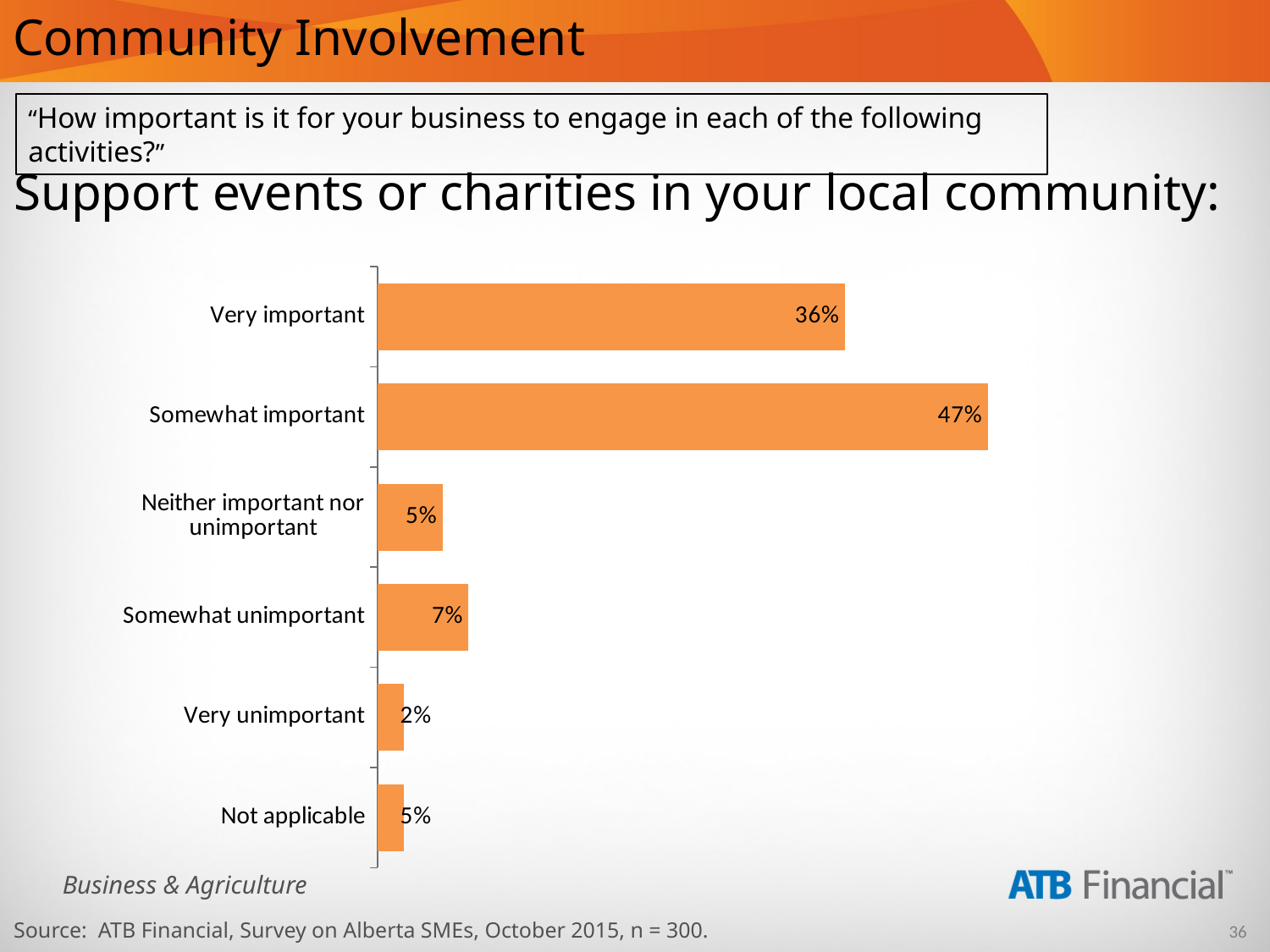
What is the value shown for "Not applicable"? 5% What is the difference in percentage points between "Somewhat important" and "Very important"? 11 Which response category has the highest percentage? Somewhat important What is the combined percentage of respondents who said "Very important" or "Somewhat important"? 83% Which response category has the lowest percentage? Very unimportant Which is larger, the value for "Somewhat unimportant" or the value for "Very unimportant"? Somewhat unimportant How many response categories are shown in the chart? 6 What is the value shown for "Somewhat unimportant"? 7% What is the value shown for "Very unimportant"? 2% What percentage of respondents said it is "Somewhat important"? 47% What kind of chart is shown on the slide? Bar chart What percentage of respondents said supporting events or charities in the local community is "Very important"? 36%